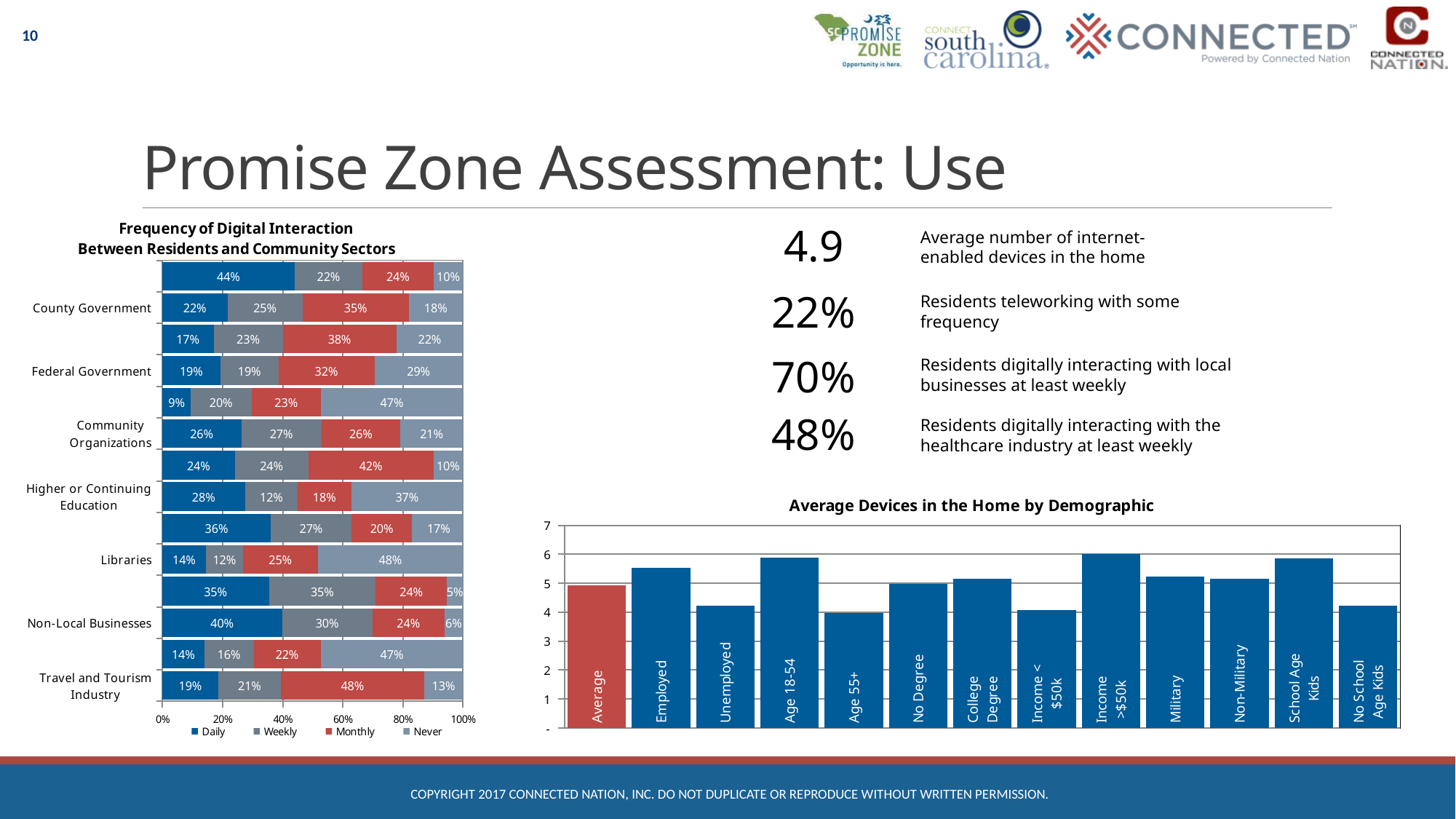
In the 'Frequency of Digital Interaction Between Residents and Community Sectors' chart, what is the Never share for Libraries? 48% In the 'Average Devices in the Home by Demographic' chart, is the value for Employed greater or less than 5? greater In the 'Average Devices in the Home by Demographic' chart, which bar is coloured differently from the others? Average In the 'Average Devices in the Home by Demographic' chart, is the value for Unemployed greater or less than 5? less In the 'Frequency of Digital Interaction Between Residents and Community Sectors' chart, what is the Daily share for Non-Local Businesses? 40% How many demographic categories are shown in the 'Average Devices in the Home by Demographic' chart? 13 In the 'Frequency of Digital Interaction Between Residents and Community Sectors' chart, what is the difference between the Never share and the Daily share for Federal Government? 10% In the 'Frequency of Digital Interaction Between Residents and Community Sectors' chart, what is the Monthly share for the Travel and Tourism Industry? 48% How many series does the legend of the 'Frequency of Digital Interaction Between Residents and Community Sectors' chart list? 4 In the 'Average Devices in the Home by Demographic' chart, is the value for Age 18-54 greater or less than 5? greater What kind of chart is 'Average Devices in the Home by Demographic'? Bar chart In the 'Average Devices in the Home by Demographic' chart, which is larger: School Age Kids or No School Age Kids? School Age Kids